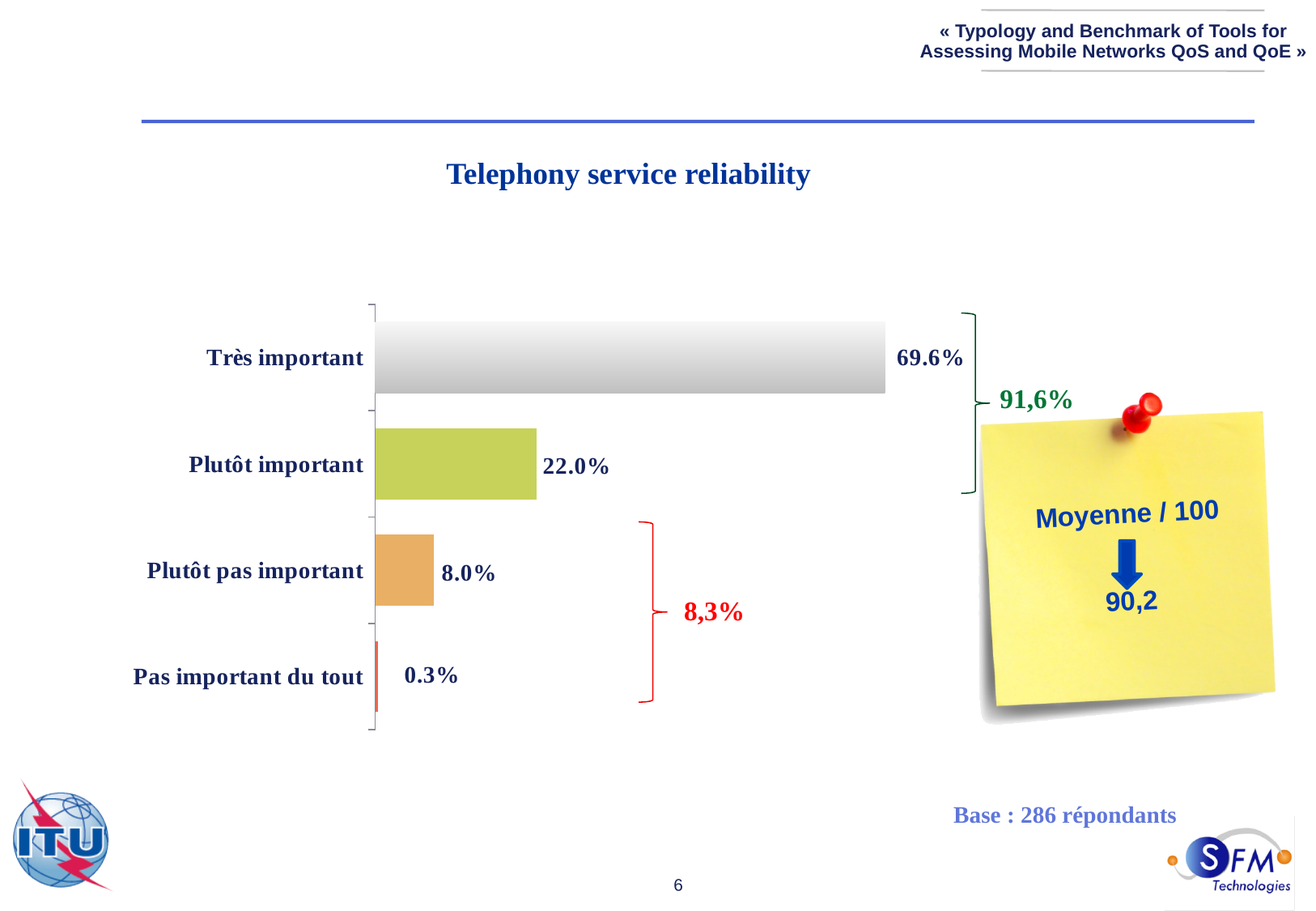
Which is larger, the value for "Plutôt important" or the value for "Plutôt pas important"? Plutôt important What is the value for "Très important"? 69.6% What is the value for "Pas important du tout"? 0.3% What is the difference between the values for "Très important" and "Plutôt important"? 47.6% What kind of chart is shown on the slide? Bar chart How many categories are shown in the chart? 4 Which category has the highest value? Très important What is the value for "Plutôt important"? 22.0% What is the combined percentage shown by the bracket for "Plutôt pas important" and "Pas important du tout"? 8,3% Which category has the lowest value? Pas important du tout What is the value for "Plutôt pas important"? 8.0% What is the title of the chart? Telephony service reliability